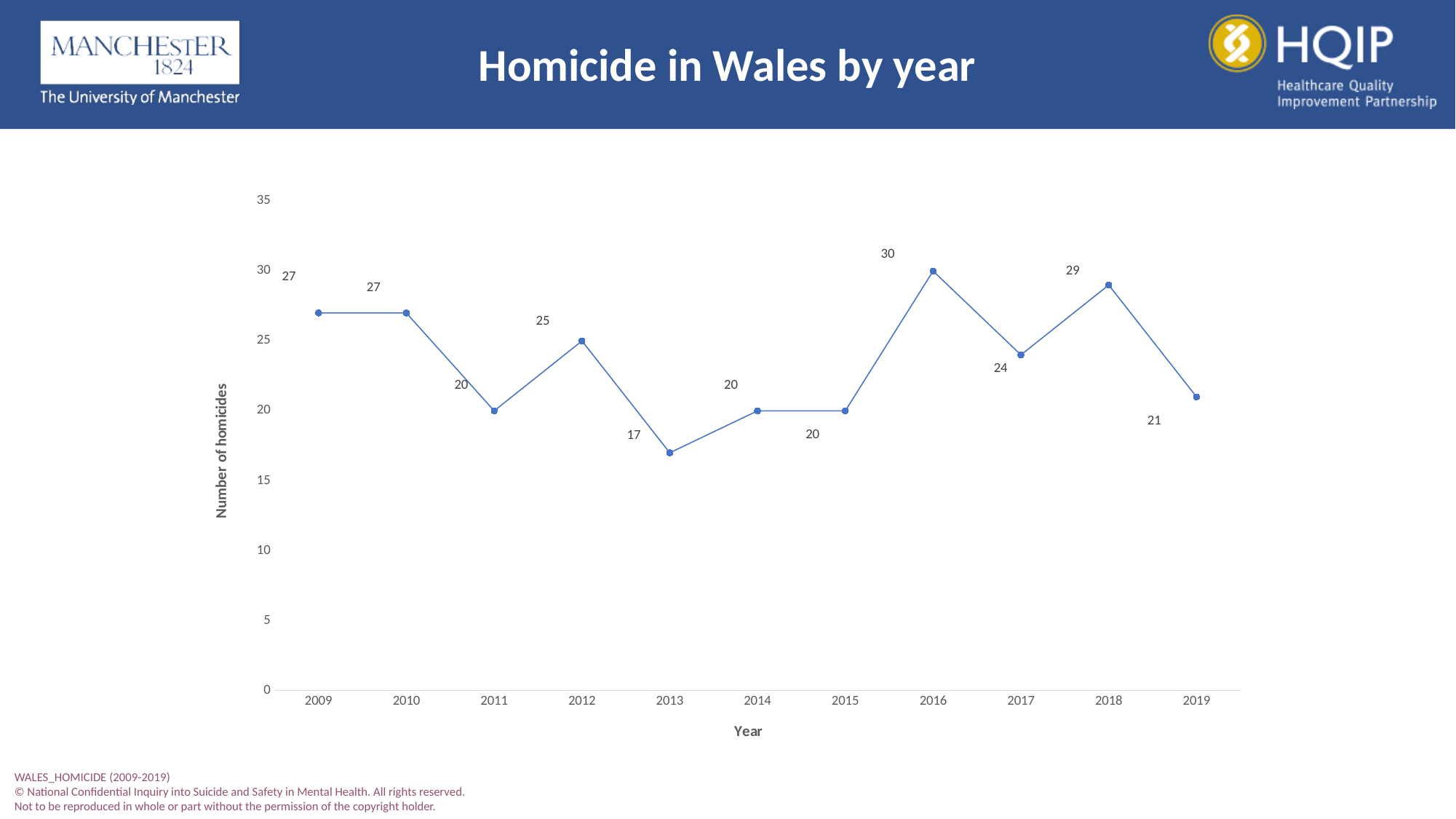
Which year has the highest number of homicides? 2016 Which year had more homicides, 2012 or 2017? 2012 Is the number of homicides in 2018 greater or less than 25? greater What is the number of homicides in Wales in 2013? 17 Which year has the lowest number of homicides? 2013 What is the number of homicides in Wales in 2016? 30 What is the difference in the number of homicides between 2016 and 2013? 13 What is the difference in the number of homicides between 2018 and 2017? 5 What kind of chart is shown on the slide? line chart How many years are plotted on the chart? 11 What is the number of homicides in Wales in 2019? 21 What is the title of the chart? Homicide in Wales by year